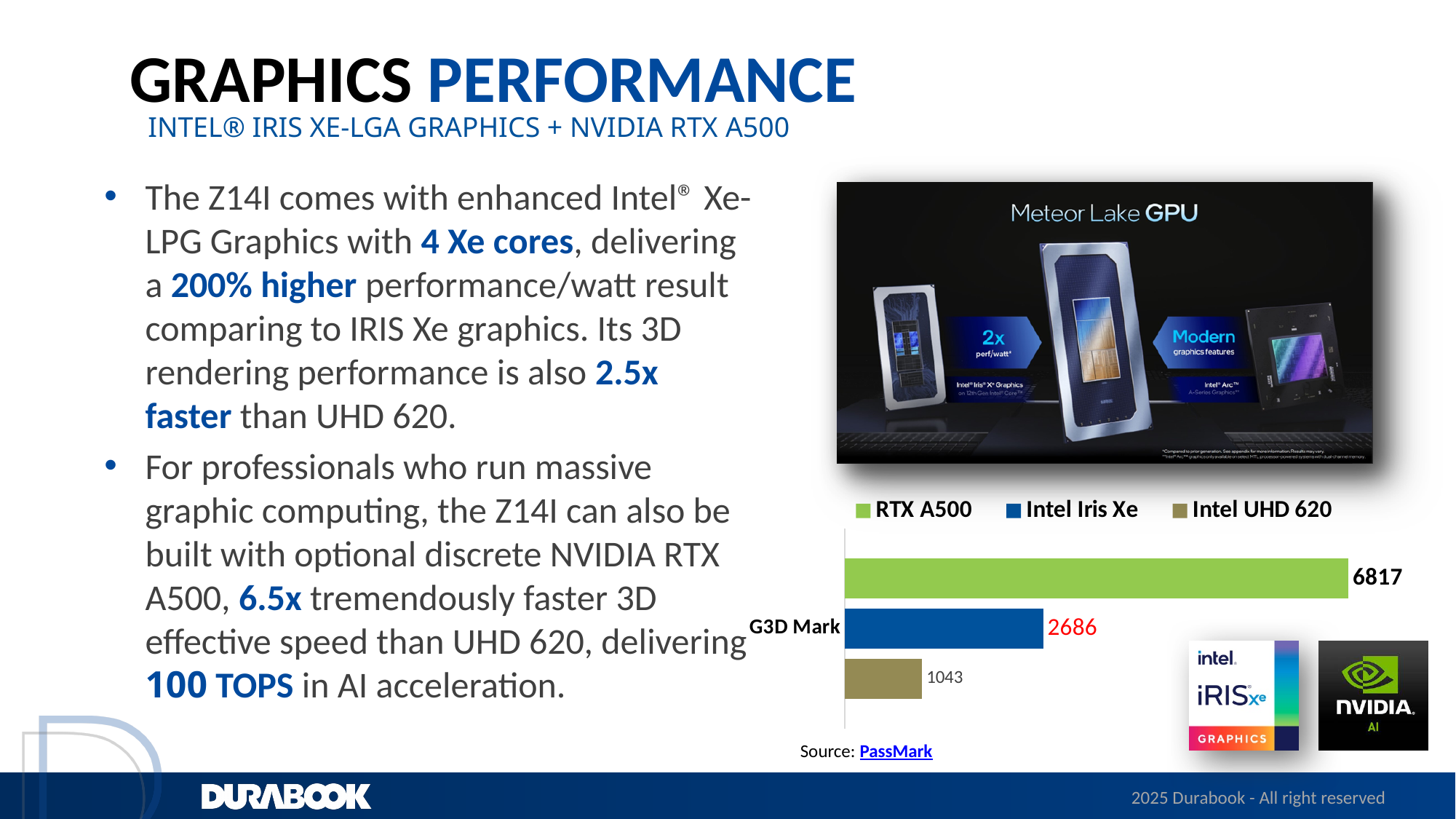
What is the difference between the G3D Mark scores of the RTX A500 and Intel Iris Xe? 4131 Which has a higher G3D Mark score, Intel Iris Xe or Intel UHD 620? Intel Iris Xe What is the G3D Mark score shown for Intel Iris Xe? 2686 What is the difference between the G3D Mark scores of Intel Iris Xe and Intel UHD 620? 1643 What kind of chart is used to show the G3D Mark scores? Bar chart What is the G3D Mark score shown for the RTX A500? 6817 Which series has the lowest G3D Mark score in the chart? Intel UHD 620 What is the category label shown on the chart's axis? G3D Mark What is the G3D Mark score shown for Intel UHD 620? 1043 Which series has the highest G3D Mark score in the chart? RTX A500 What colour is the bar for the RTX A500 in the chart? Green How many series does the chart legend list? 3